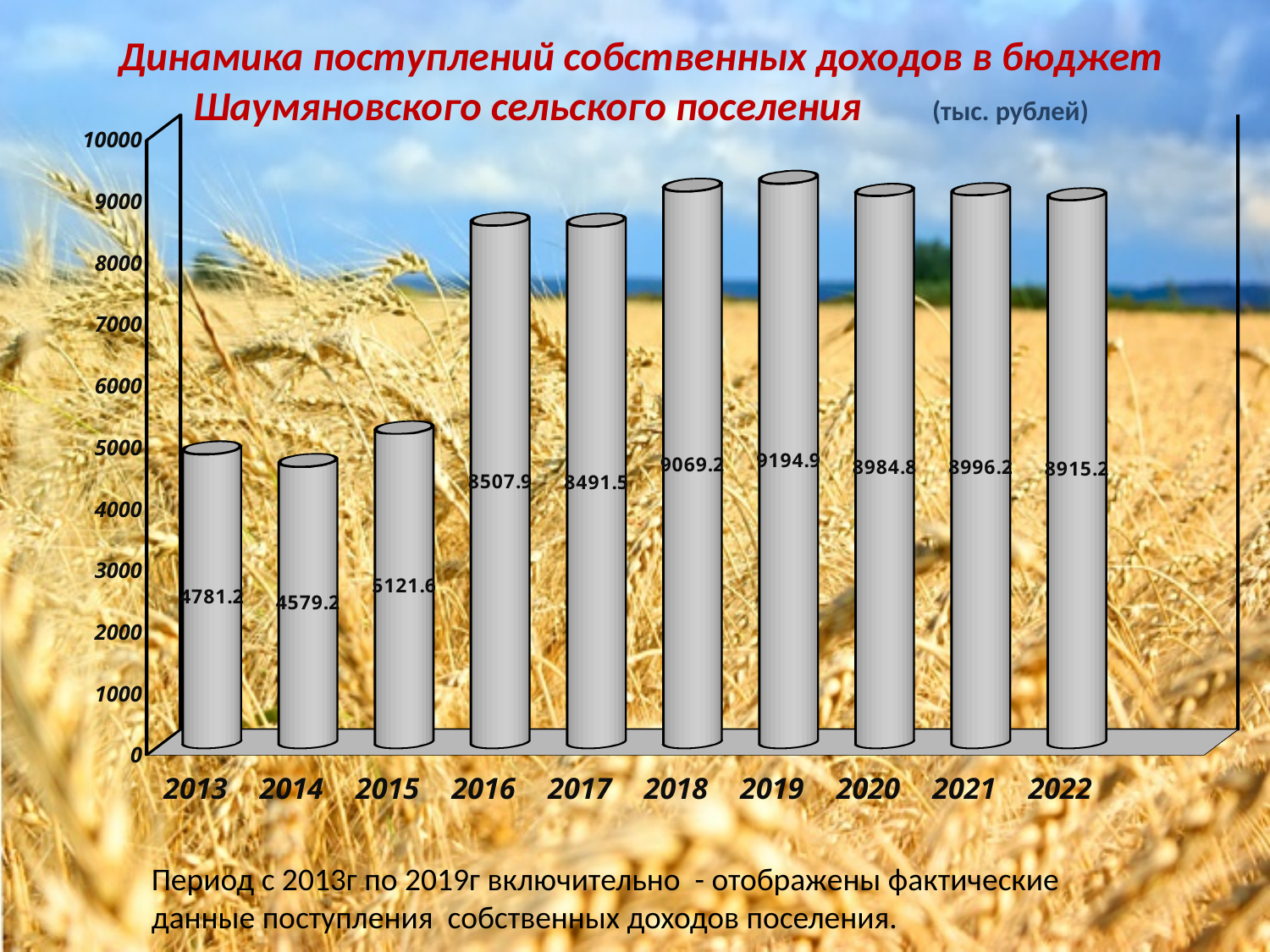
What is the value for 2022? 8915.2 Which is larger, the value for 2017 or the value for 2018? 2018 What kind of chart is shown on the slide? bar chart Is the value for 2016 greater or less than 8000? greater What is the difference between the values for 2015 and 2014? 542.4 What is the difference between the values for 2019 and 2013? 4413.7 What is the value for 2013? 4781.2 What is the value for 2019? 9194.9 From 2014 to 2016, do the values rise or fall? rise Which year has the lowest value? 2014 How many years are shown on the x axis? 10 Which year has the highest value? 2019